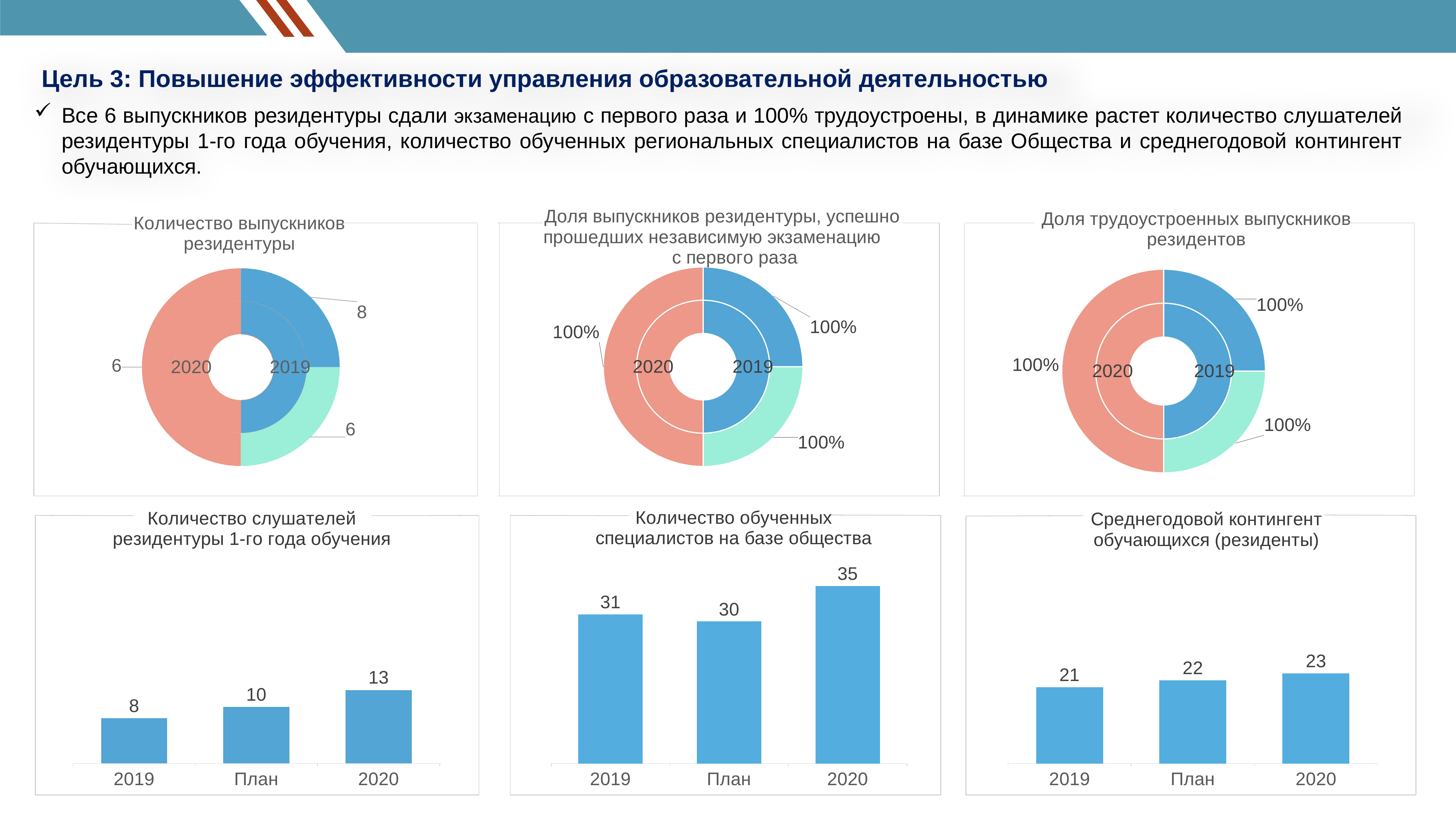
In the chart 'Количество слушателей резидентуры 1-го года обучения', what is the value for План? 10 In the chart 'Количество обученных специалистов на базе общества', which category has the highest value? 2020 In the chart 'Количество слушателей резидентуры 1-го года обучения', what is the difference between the 2020 value and the 2019 value? 5 In the chart 'Среднегодовой контингент обучающихся (резиденты)', what is the difference between the 2020 value and the 2019 value? 2 In the chart 'Среднегодовой контингент обучающихся (резиденты)', do the values rise or fall from 2019 to 2020? rise In the chart 'Количество обученных специалистов на базе общества', which is larger: the value for 2019 or the value for План? 2019 In the chart 'Количество обученных специалистов на базе общества', what is the value for 2019? 31 In the chart 'Количество слушателей резидентуры 1-го года обучения', which category has the lowest value? 2019 In the chart 'Среднегодовой контингент обучающихся (резиденты)', what is the value for План? 22 In the chart 'Количество слушателей резидентуры 1-го года обучения', what is the value for 2020? 13 What kind of chart is 'Доля трудоустроенных выпускников резидентов'? doughnut chart How many categories are shown on the x axis of the chart 'Количество обученных специалистов на базе общества'? 3